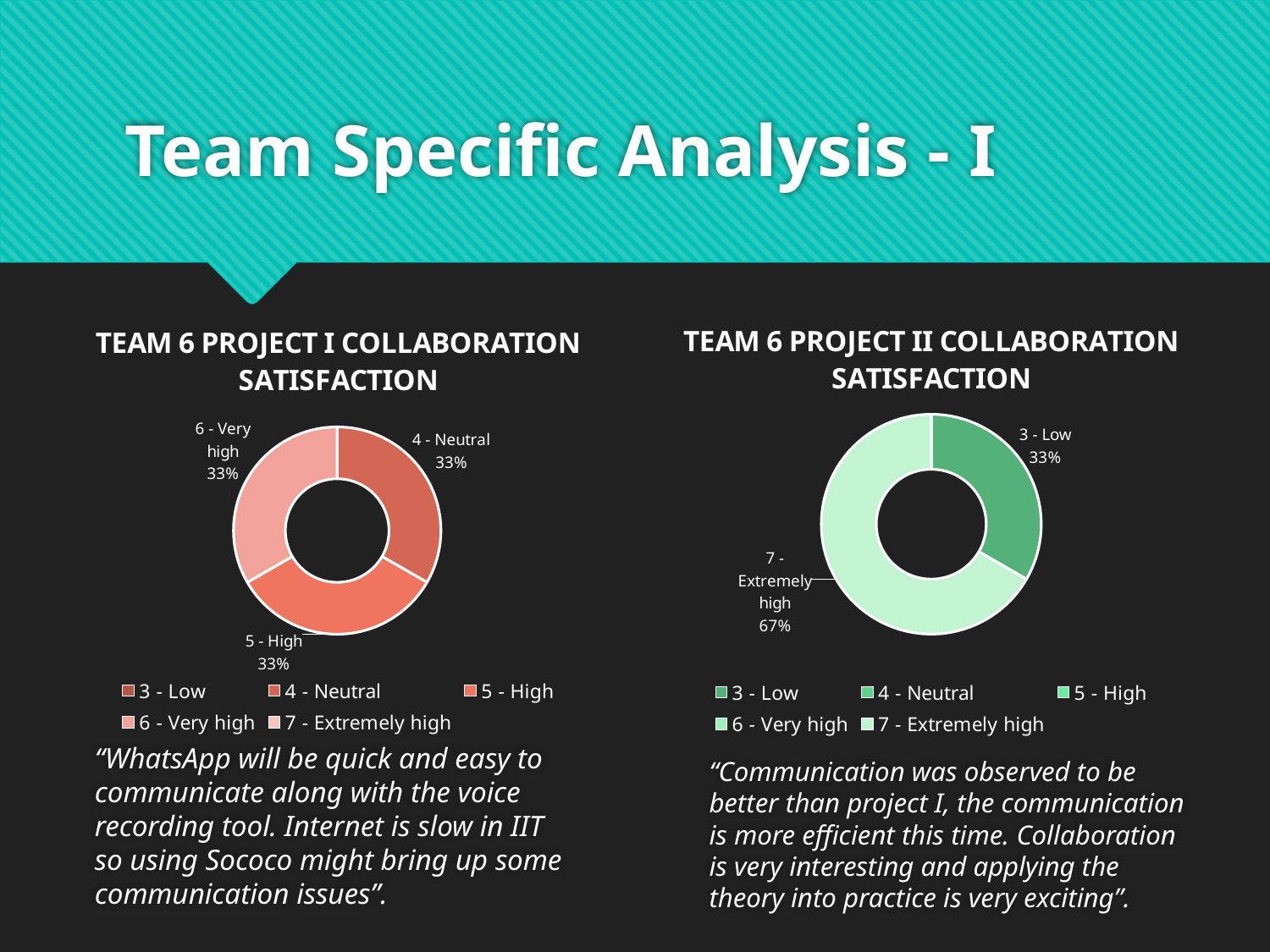
What kind of chart is the Team 6 Project II Collaboration Satisfaction chart? Doughnut chart In the Team 6 Project II Collaboration Satisfaction chart, what share is labelled for 7 - Extremely high? 67% In the Team 6 Project II Collaboration Satisfaction chart, which is larger: 3 - Low or 7 - Extremely high? 7 - Extremely high In the Team 6 Project II Collaboration Satisfaction chart, which category has the smallest share? 3 - Low How many slices with data labels are shown in the Team 6 Project I Collaboration Satisfaction chart? 3 How many slices with data labels are shown in the Team 6 Project II Collaboration Satisfaction chart? 2 How many entries does the legend of the Team 6 Project I Collaboration Satisfaction chart list? 5 In the Team 6 Project I Collaboration Satisfaction chart, what share is labelled for 6 - Very high? 33% In the Team 6 Project II Collaboration Satisfaction chart, what is the difference in percentage points between 7 - Extremely high and 3 - Low? 34 percentage points In the Team 6 Project I Collaboration Satisfaction chart, what share is labelled for 4 - Neutral? 33% In the Team 6 Project II Collaboration Satisfaction chart, what share is labelled for 3 - Low? 33% In the Team 6 Project II Collaboration Satisfaction chart, which category has the largest share? 7 - Extremely high